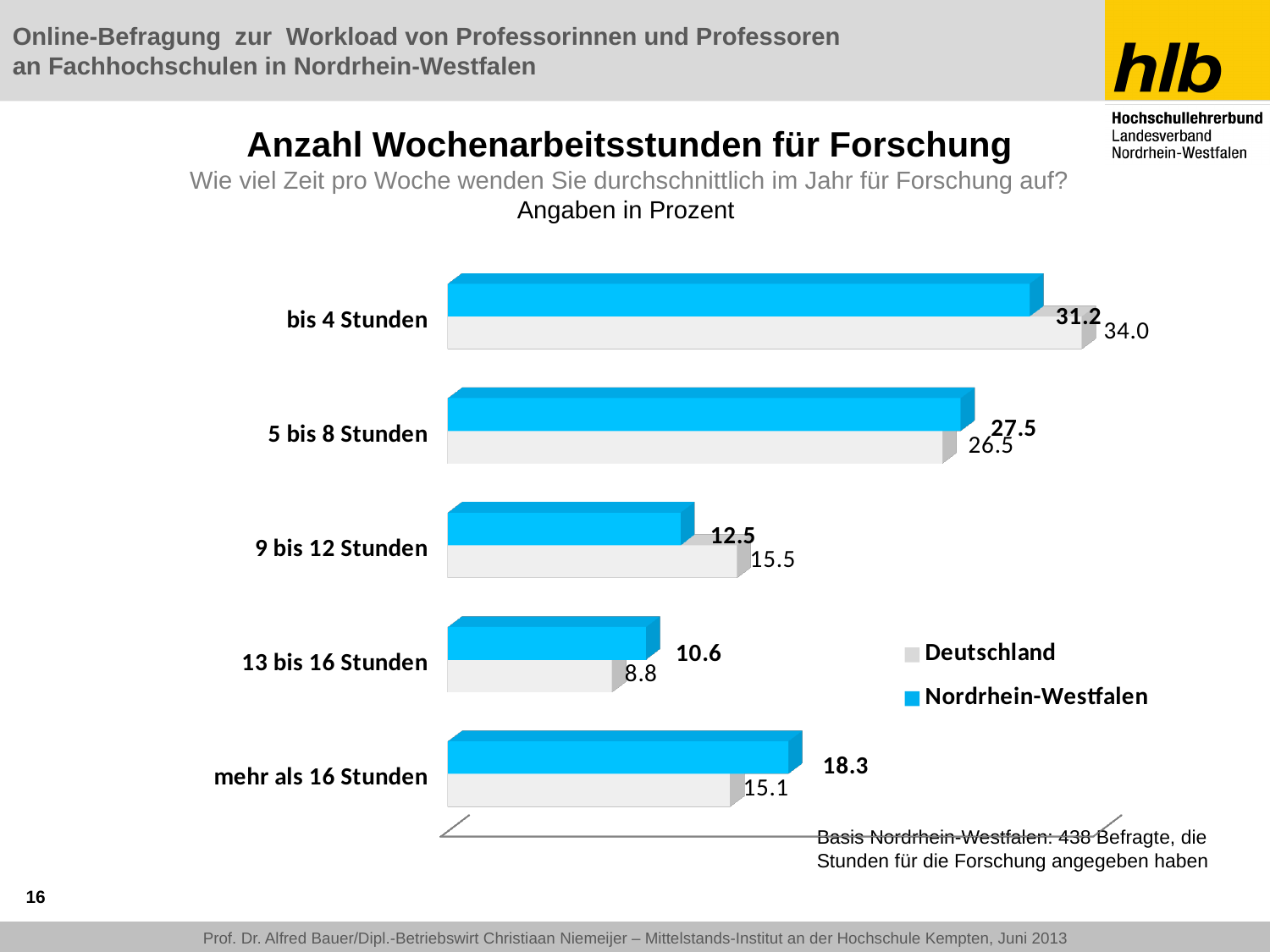
What is the value for Deutschland in the category '13 bis 16 Stunden'? 8.8 What is the difference between the Deutschland and Nordrhein-Westfalen values in the category '9 bis 12 Stunden'? 3.0 What is the value for Deutschland in the category 'bis 4 Stunden'? 34.0 What is the value for Nordrhein-Westfalen in the category 'bis 4 Stunden'? 31.2 How many series does the legend list? 2 In the category 'mehr als 16 Stunden', which series has the larger value, Deutschland or Nordrhein-Westfalen? Nordrhein-Westfalen How many categories are shown on the chart? 5 What kind of chart is shown on the slide? bar chart Which colour represents Nordrhein-Westfalen in the chart? blue Which category has the highest value for Nordrhein-Westfalen? bis 4 Stunden What is the value for Nordrhein-Westfalen in the category 'mehr als 16 Stunden'? 18.3 Which category has the lowest value for Deutschland? 13 bis 16 Stunden